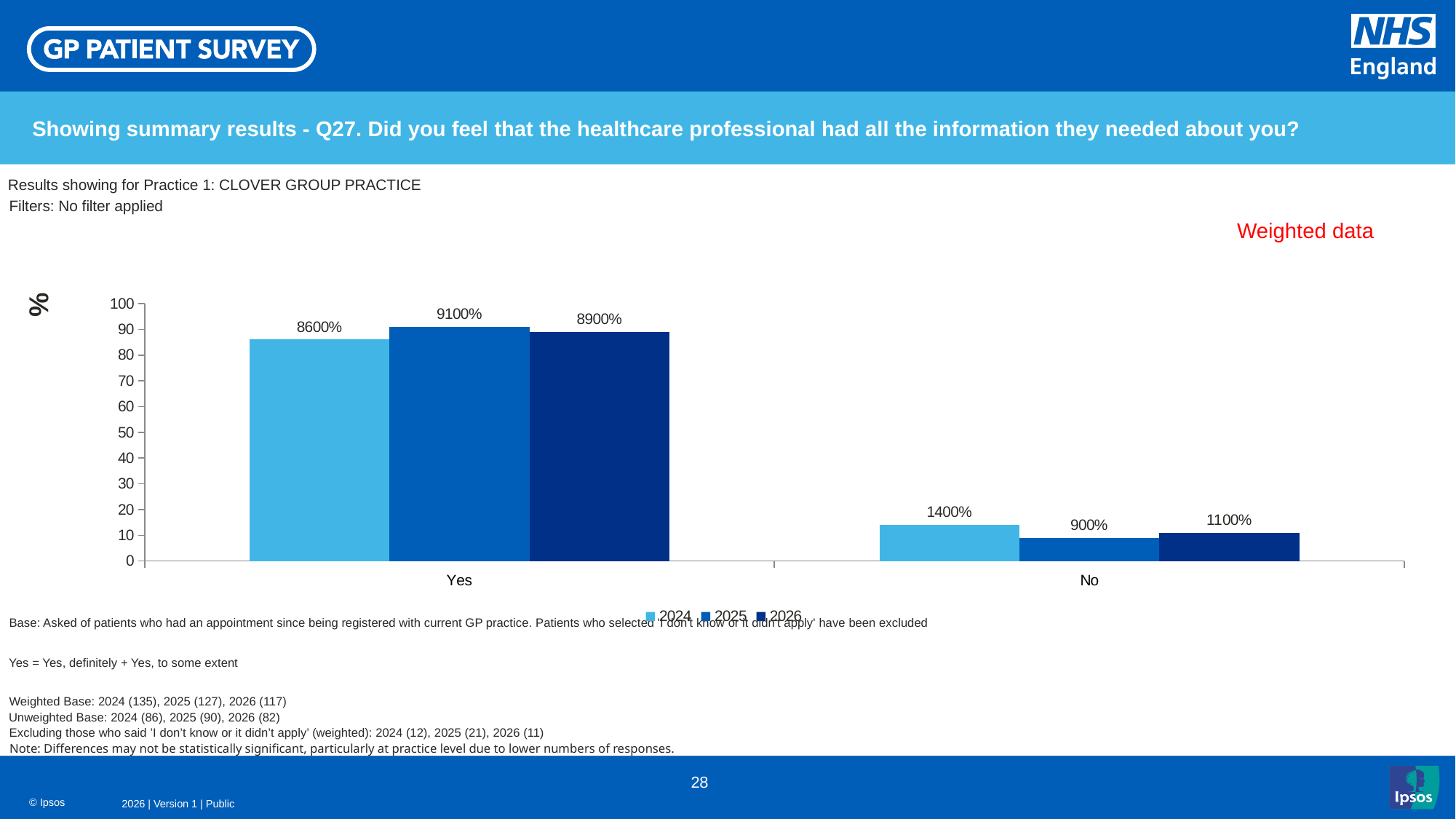
What is the data label shown for 2026 in the No category? 1100% What is the data label shown for 2025 in the Yes category? 9100% Which year has the lowest bar in the No category? 2025 What kind of chart is shown on the slide? Bar chart What are the legend entries for the chart? 2024, 2025, 2026 Which year has the highest bar in the Yes category? 2025 How many series does the legend list? 3 Is the 2024 bar in the No category greater or less than 10 on the axis? greater Is the 2026 bar in the Yes category taller than the 2024 bar in the Yes category? Yes What is the data label shown for 2024 in the No category? 1400% How many categories are shown on the x axis? 2 What is the data label shown for 2024 in the Yes category? 8600%